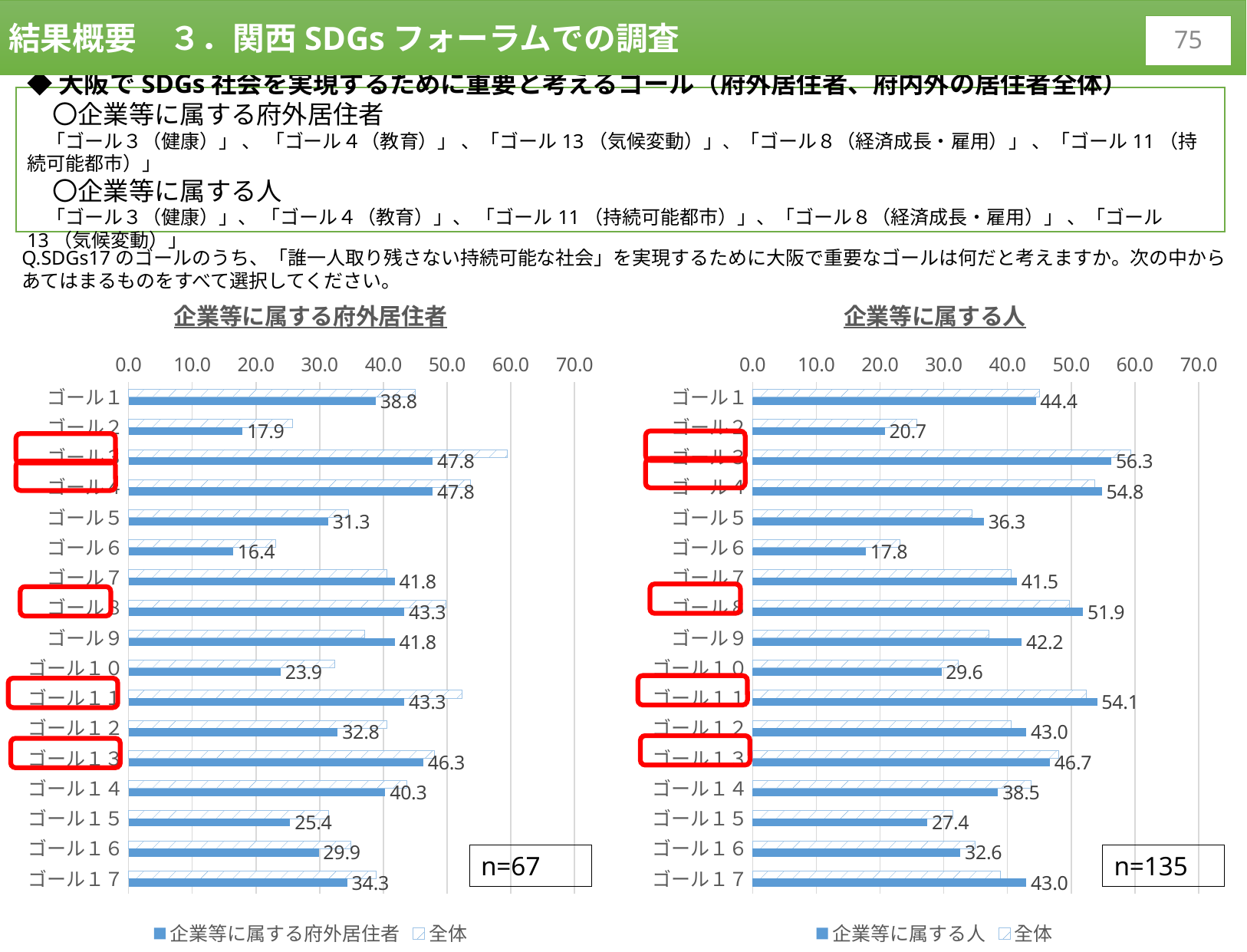
What kind of chart is the left chart titled 企業等に属する府外居住者? bar chart In the right chart titled 企業等に属する人, which goal has the highest value for the 企業等に属する人 series? ゴール３ In the right chart titled 企業等に属する人, what is the difference between the values for ゴール８ and ゴール７ in the 企業等に属する人 series? 10.4 In the left chart titled 企業等に属する府外居住者, what is the value for ゴール１３ for the 企業等に属する府外居住者 series? 46.3 In the left chart titled 企業等に属する府外居住者, what is the difference between the values for ゴール３ and ゴール２ in the 企業等に属する府外居住者 series? 29.9 How many goal categories are shown in the left chart titled 企業等に属する府外居住者? 17 In the right chart titled 企業等に属する人, is the value for ゴール１０ in the 企業等に属する人 series greater or less than 30.0? less In the right chart titled 企業等に属する人, which goal has the lowest value for the 企業等に属する人 series? ゴール６ How many series does the legend of the right chart titled 企業等に属する人 list? 2 In the right chart titled 企業等に属する人, what is the value for ゴール１１ for the 企業等に属する人 series? 54.1 In the left chart titled 企業等に属する府外居住者, which goal has the lowest value for the 企業等に属する府外居住者 series? ゴール６ In the left chart titled 企業等に属する府外居住者, which is larger for the 企業等に属する府外居住者 series: ゴール１４ or ゴール１７? ゴール１４